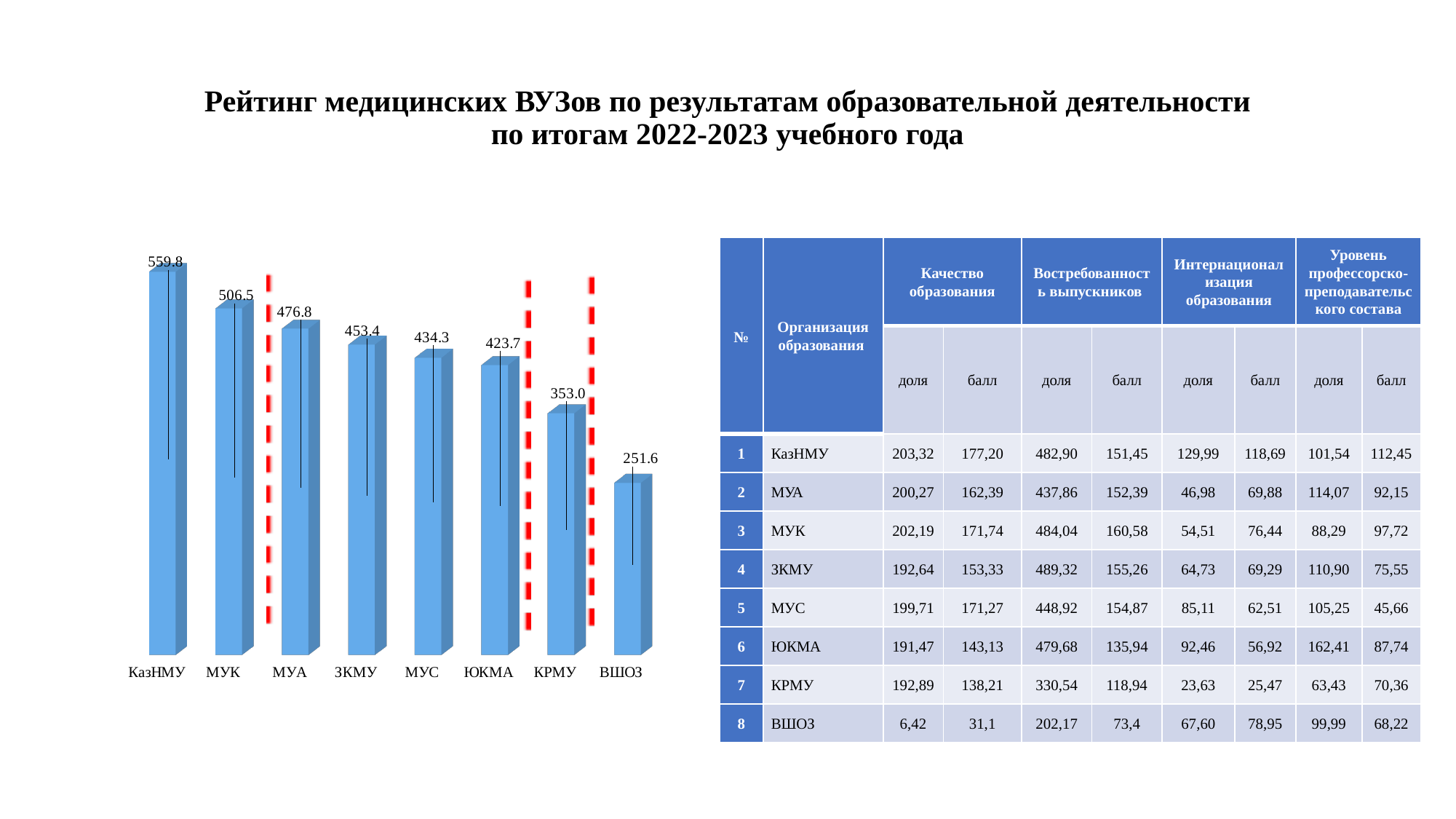
Which has a larger value in the chart, МУА or ЗКМУ? МУА What is the value shown for КазНМУ in the chart? 559.8 Which organisation has the highest value in the chart? КазНМУ What is the value shown for МУС in the chart? 434.3 What is the value shown for ВШОЗ in the chart? 251.6 What is the difference between the values for КазНМУ and МУК in the chart? 53.3 How many organisations are shown as bars in the chart? 8 What colour are the bars in the chart? blue What type of chart is shown on the slide? bar chart What is the difference between the values for КРМУ and ВШОЗ in the chart? 101.4 Which organisation has the lowest value in the chart? ВШОЗ Do the values in the chart rise or fall from left to right? fall